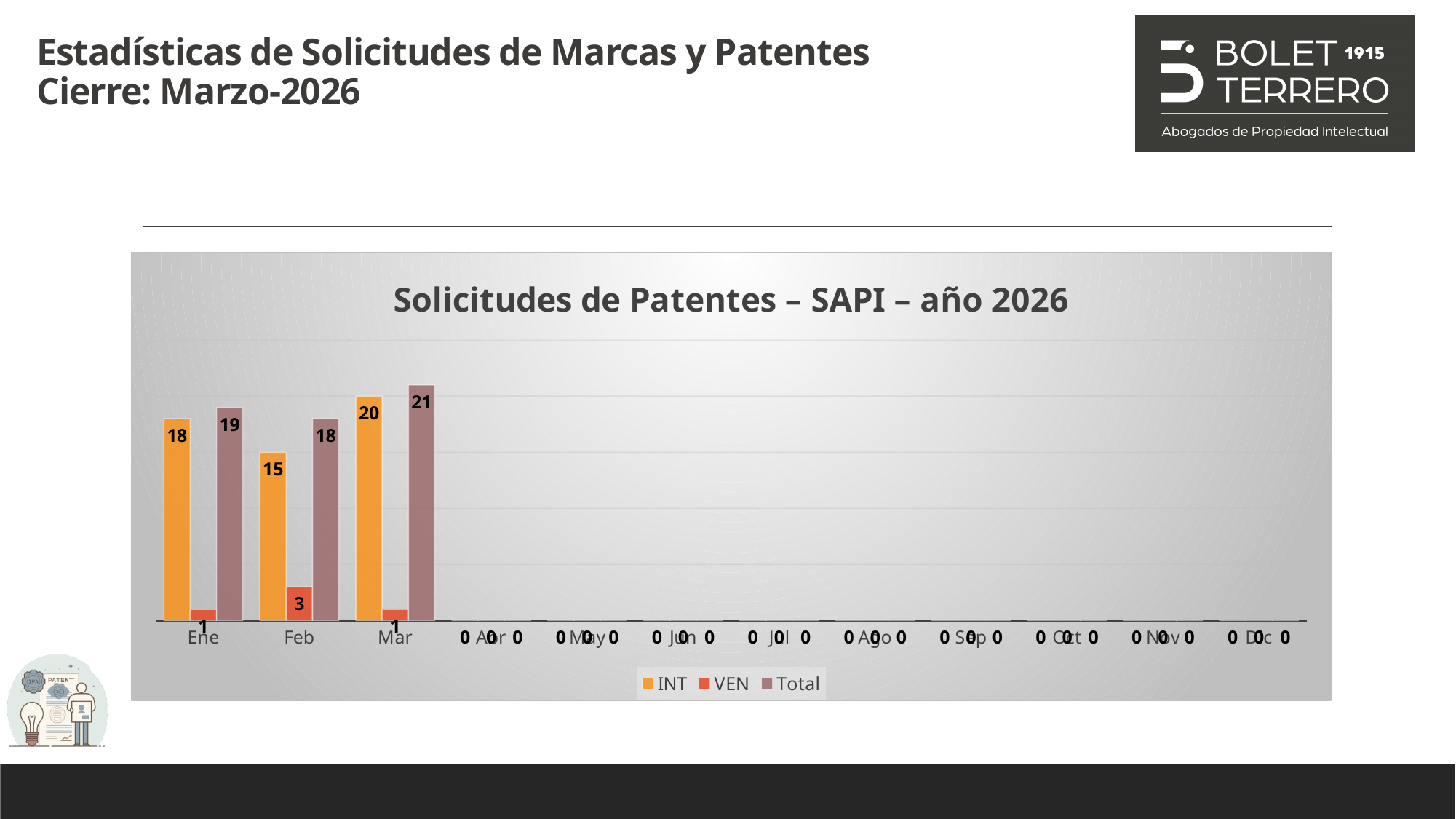
What is the difference between the INT values for Mar and Feb? 5 What type of chart is shown on the slide? bar chart What is the INT value for Ene? 18 Among Ene, Feb and Mar, which month has the lowest INT value? Feb Which month has the highest Total value? Mar What is the Total value for Mar? 21 Which is larger, the Total for Ene or the Total for Feb? Total for Ene How many month categories are shown on the x axis? 12 Which series is shown in orange in the legend? INT What is the title of the chart? Solicitudes de Patentes – SAPI – año 2026 How many series does the legend list? 3 What is the VEN value for Feb? 3